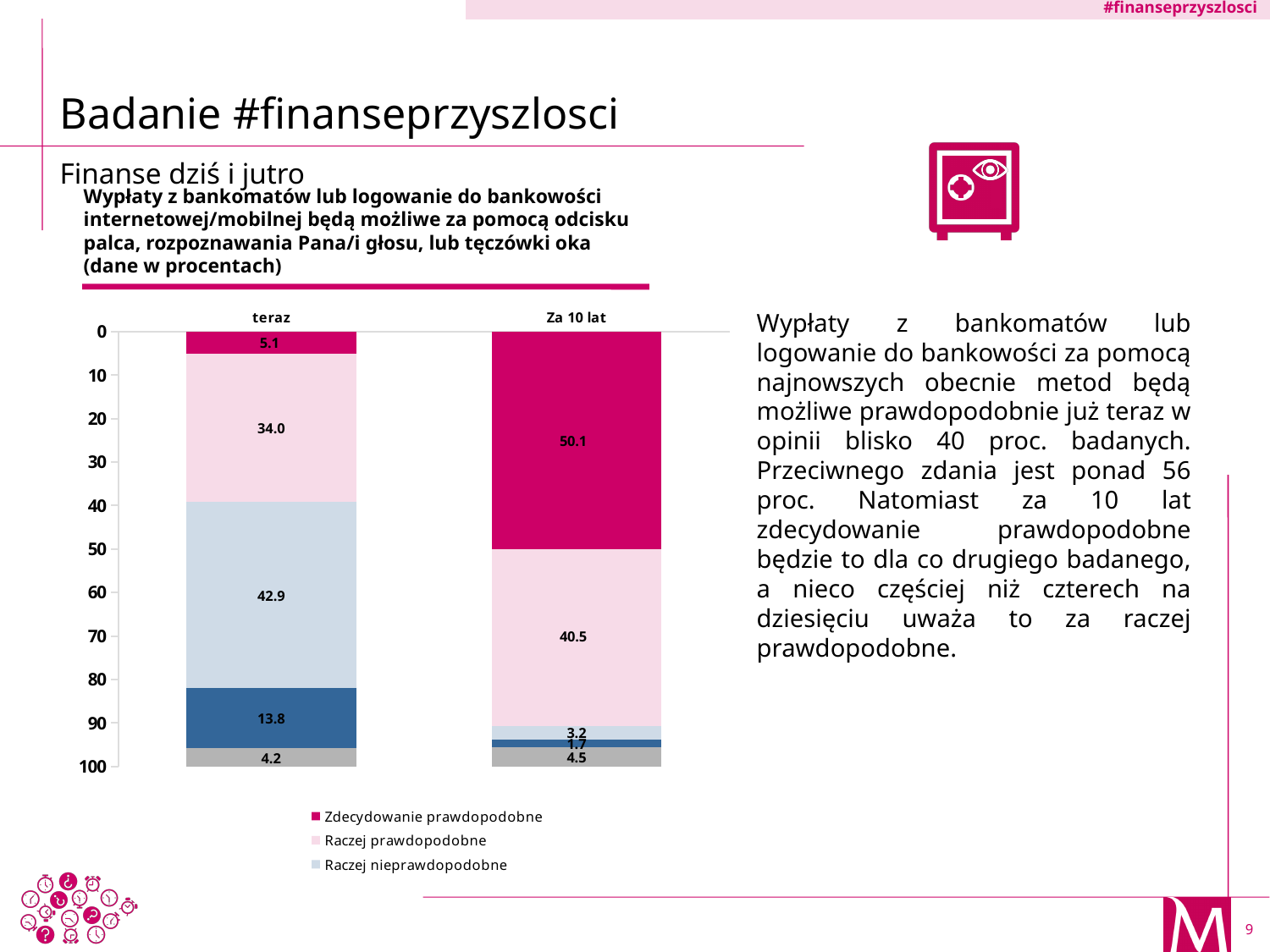
What is the difference between the 'Zdecydowanie prawdopodobne' values for 'Za 10 lat' and 'teraz'? 45.0 What is the first entry listed in the chart's legend? Zdecydowanie prawdopodobne What is the total of all segments in the 'teraz' bar? 100.0 What is the value of the 'Raczej prawdopodobne' segment for 'Za 10 lat'? 40.5 Which segment is the largest in the 'teraz' bar? Raczej nieprawdopodobne (42.9) What is the value of the 'Zdecydowanie prawdopodobne' segment for 'Za 10 lat'? 50.1 What is the value of the 'Raczej nieprawdopodobne' segment for 'teraz'? 42.9 How many categories (bars) are shown on the x axis of the chart? 2 What is the value of the 'Zdecydowanie prawdopodobne' segment for 'teraz'? 5.1 What type of chart is shown on the slide? Stacked bar chart Which category has the larger 'Raczej prawdopodobne' value, 'teraz' or 'Za 10 lat'? Za 10 lat How many series does the chart's legend list? 3